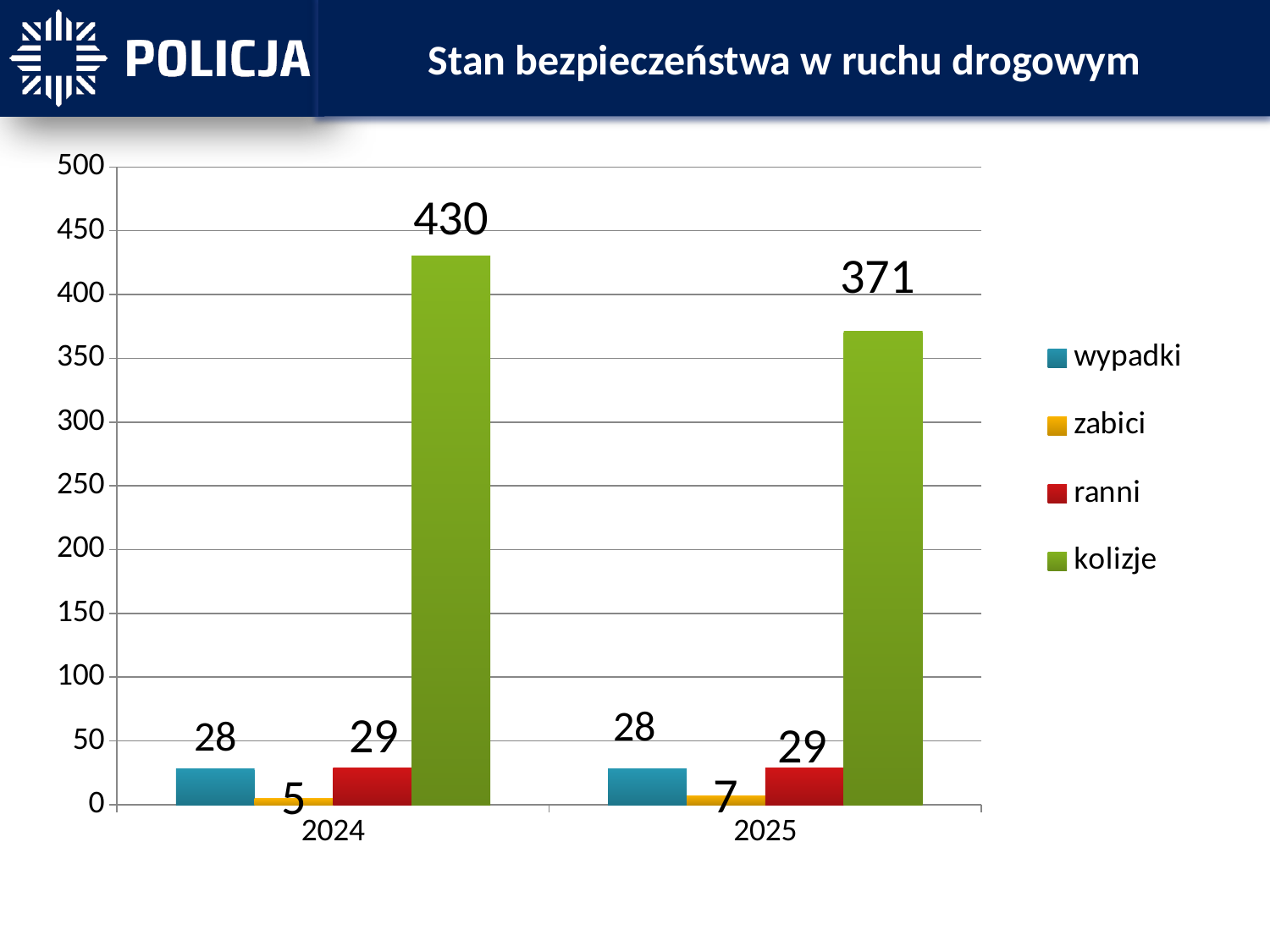
What kind of chart is shown on the slide? bar chart What is the value for ranni in 2024? 29 Which series has the lowest value in 2024? zabici Which series has the highest value in 2025? kolizje What is the difference between kolizje in 2024 and kolizje in 2025? 59 Which is larger: zabici in 2024 or zabici in 2025? zabici in 2025 What is the value for zabici in 2025? 7 How many series does the legend list? 4 What is the value for kolizje in 2024? 430 Do the values for kolizje rise or fall from 2024 to 2025? fall What is the value for wypadki in 2025? 28 How many categories are shown on the x axis? 2